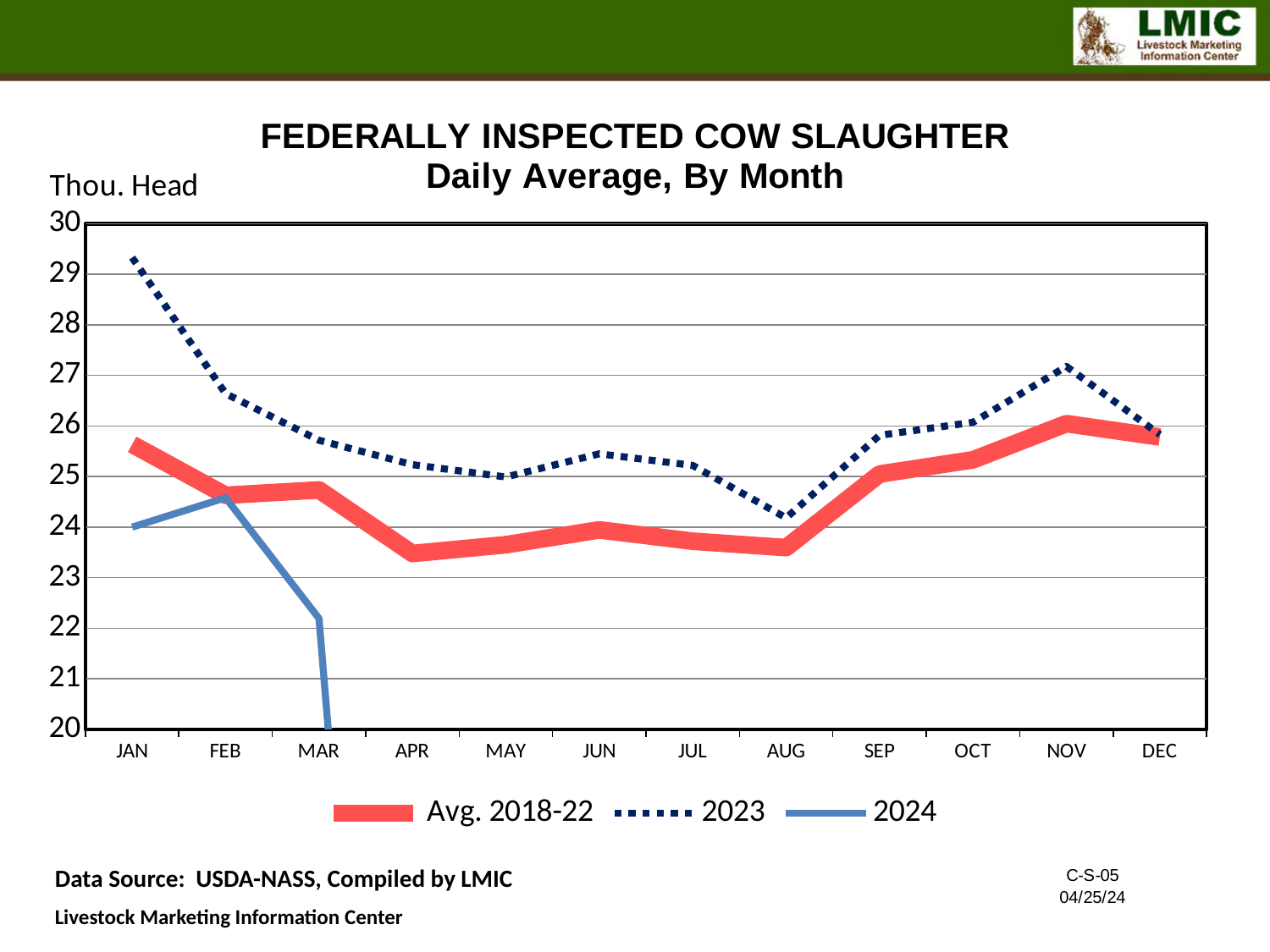
Is the 2023 value for AUG greater or less than 25? less In JAN, which series is higher: 2023 or Avg. 2018-22? 2023 In which month is the 2023 series at its lowest? AUG What unit is shown on the y axis label? Thou. Head What kind of chart is shown on the slide? line chart Does the 2023 series rise or fall from JAN to MAY? fall How many months are shown along the x axis? 12 Is the 2023 value for JAN greater or less than 28? greater How many series does the legend list? 3 Is the 2024 value for MAR greater or less than 23? less In which month is the 2023 series at its highest? JAN